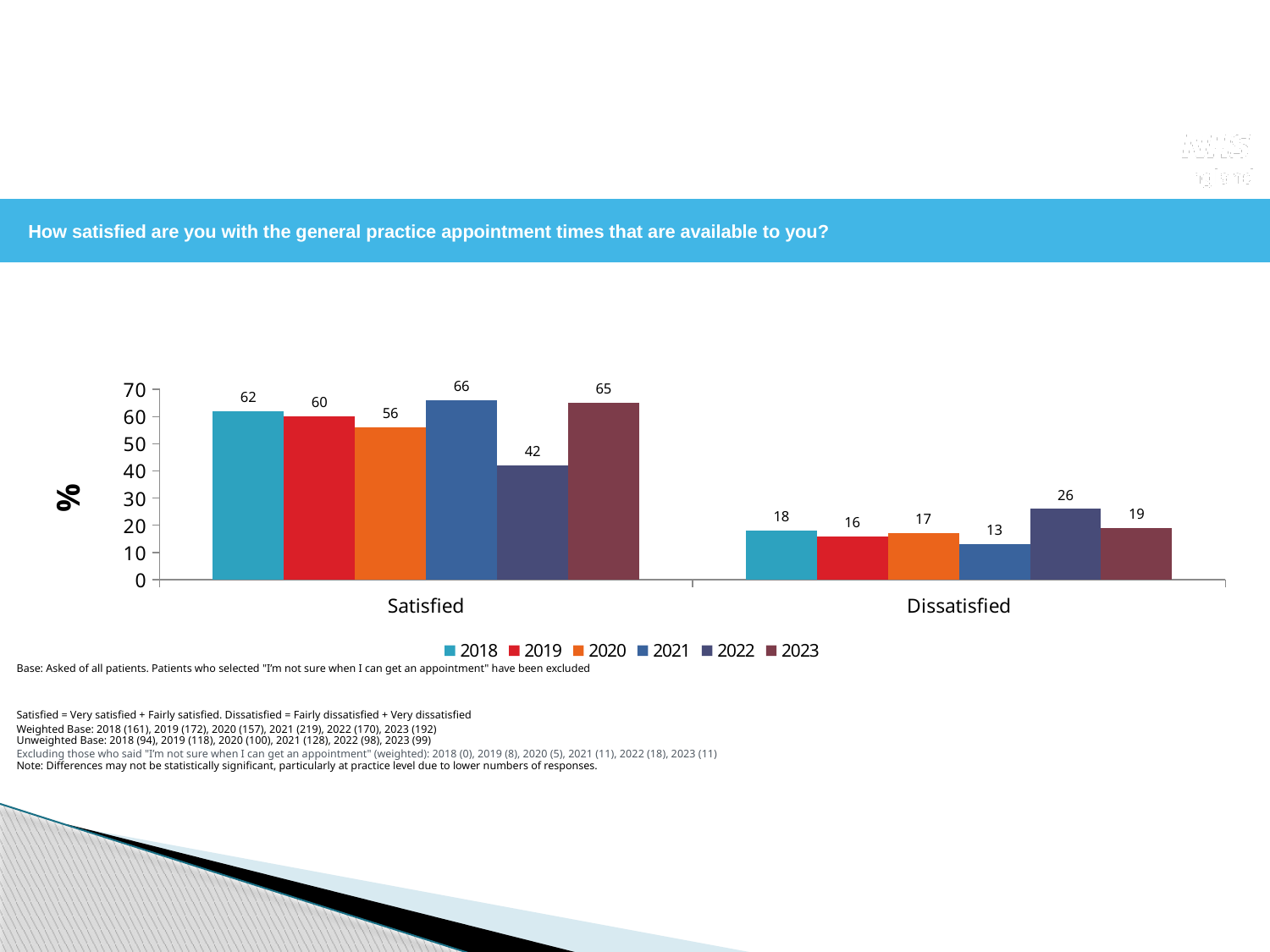
What is the value for 2018 in the Satisfied category? 62 Which year has the highest value in the Dissatisfied category? 2022 Which is larger: the 2023 value for Satisfied or the 2019 value for Satisfied? 2023 How many series does the legend list? 6 What is the label on the vertical axis? % What is the difference between the 2021 and 2022 values in the Satisfied category? 24 Which year has the lowest value in the Satisfied category? 2022 What kind of chart is shown on the slide? Bar chart What is the value for 2022 in the Dissatisfied category? 26 Which year has the lowest value in the Dissatisfied category? 2021 What is the value for 2021 in the Satisfied category? 66 How many categories are shown on the x axis? 2